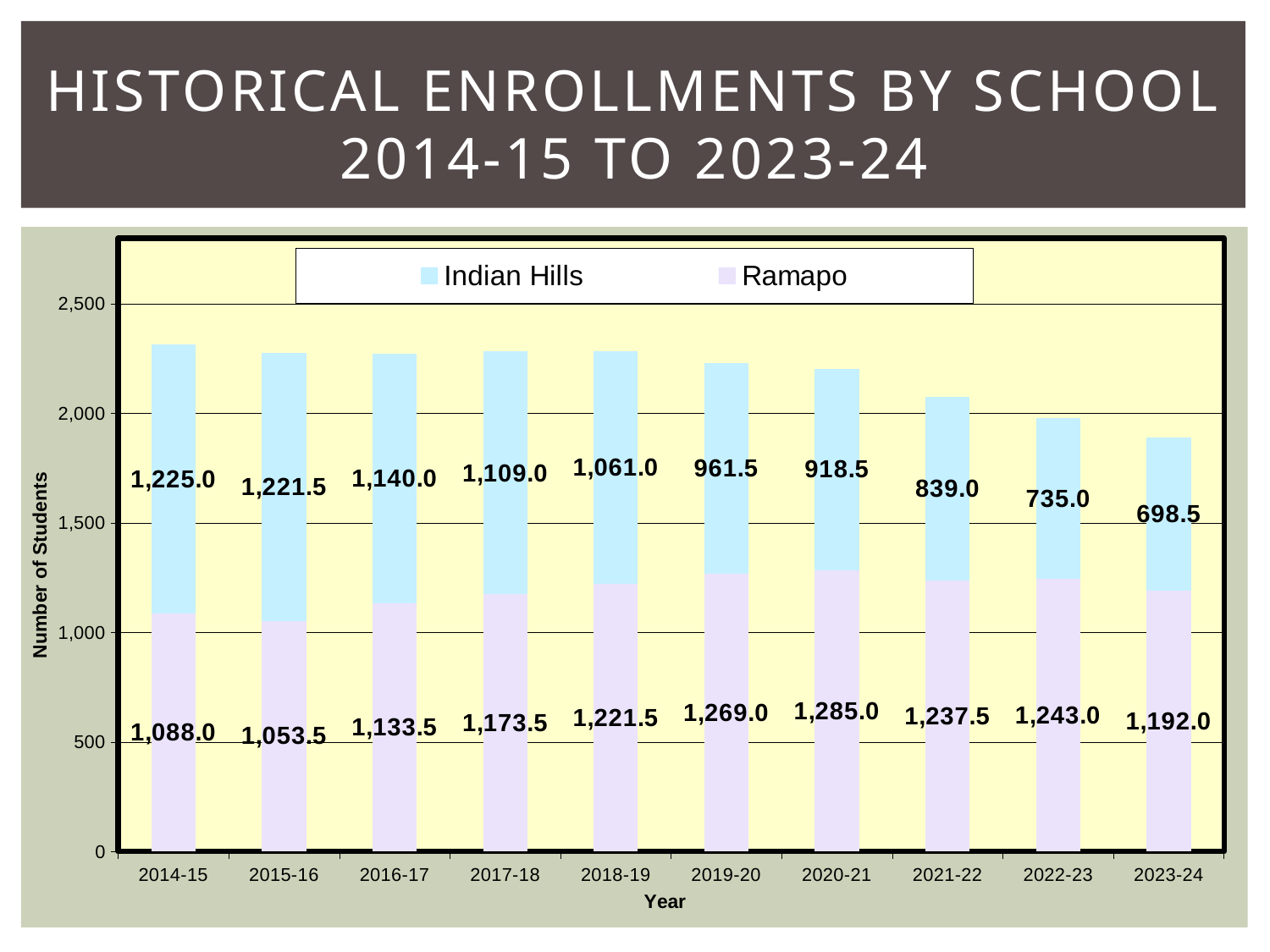
What is the difference between the Ramapo and Indian Hills enrollments in 2023-24? 493.5 What is the Ramapo enrollment for 2020-21? 1,285.0 Which school has the larger enrollment in 2016-17, Indian Hills or Ramapo? Indian Hills How many series does the legend list? 2 What is the Indian Hills enrollment for 2014-15? 1,225.0 What kind of chart is shown on the slide? Stacked bar chart In which year is the Indian Hills enrollment lowest? 2023-24 What is the Indian Hills enrollment for 2023-24? 698.5 Is the total enrollment for 2014-15 greater or less than 2,000? greater In which year is the Ramapo enrollment highest? 2020-21 What is the total enrollment (Indian Hills plus Ramapo) for 2023-24? 1,890.5 How many years are shown on the x axis? 10